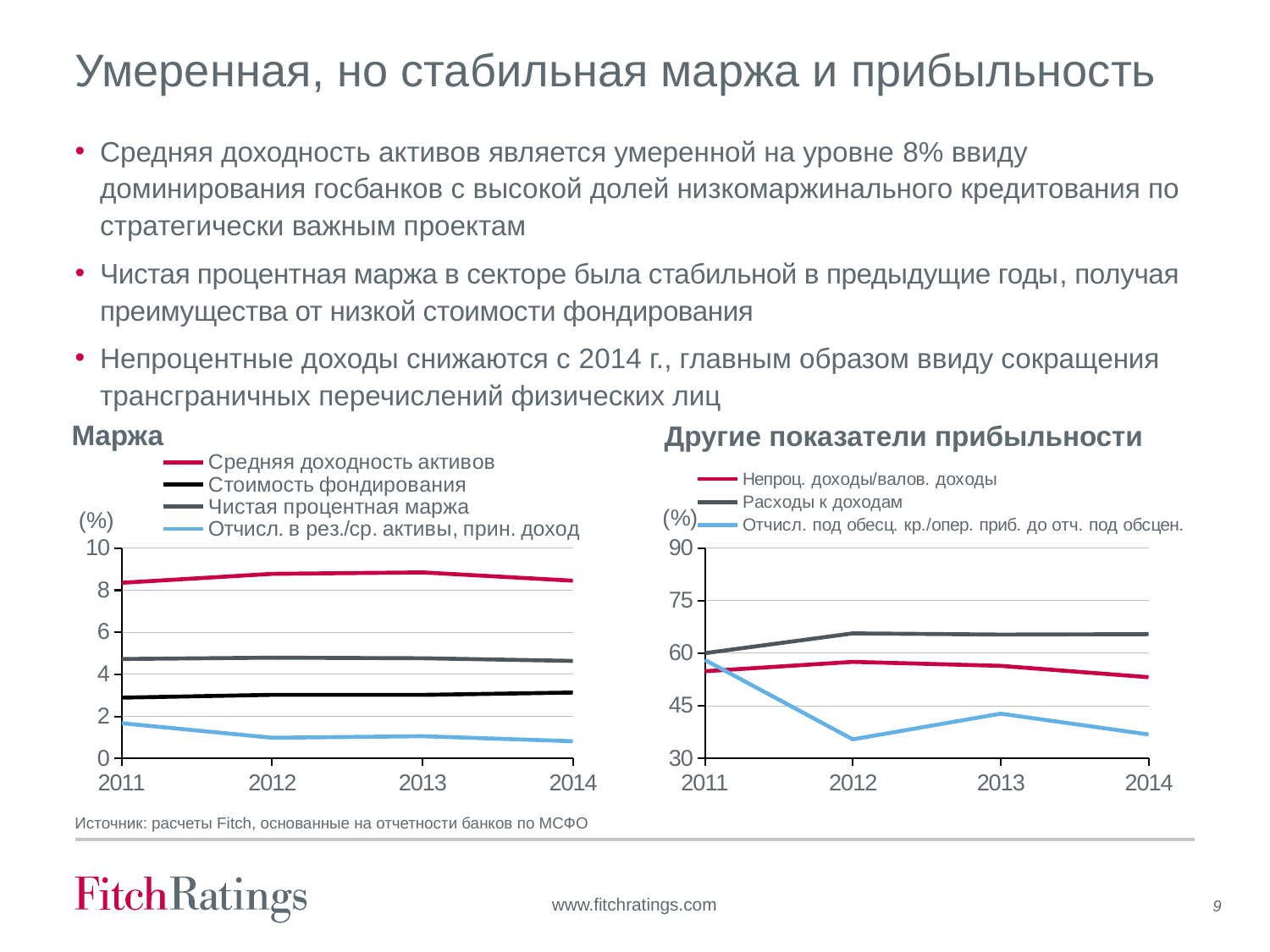
How many series does the legend of the "Маржа" chart list? 4 How many series does the legend of the "Другие показатели прибыльности" chart list? 3 In the "Маржа" chart, which series has the lowest value in 2014? Отчисл. в рез./ср. активы, прин. доход What kind of chart is the "Маржа" chart? line chart In the "Другие показатели прибыльности" chart, does the "Отчисл. под обесц. кр./опер. приб. до отч. под обсцен." series rise or fall from 2011 to 2012? fall In the "Другие показатели прибыльности" chart, is the value for "Отчисл. под обесц. кр./опер. приб. до отч. под обсцен." in 2012 greater or less than 45? less In the "Маржа" chart, is the value for "Средняя доходность активов" in 2013 greater or less than 8? greater In the "Другие показатели прибыльности" chart, which is larger in 2013: "Расходы к доходам" or "Непроц. доходы/валов. доходы"? Расходы к доходам In the "Маржа" chart, is the value for "Стоимость фондирования" in 2014 greater or less than 4? less How many years are shown on the x axis of the "Другие показатели прибыльности" chart? 4 In the "Другие показатели прибыльности" chart, which series has the highest value in 2014? Расходы к доходам In the "Маржа" chart, which series has the highest value in 2011? Средняя доходность активов